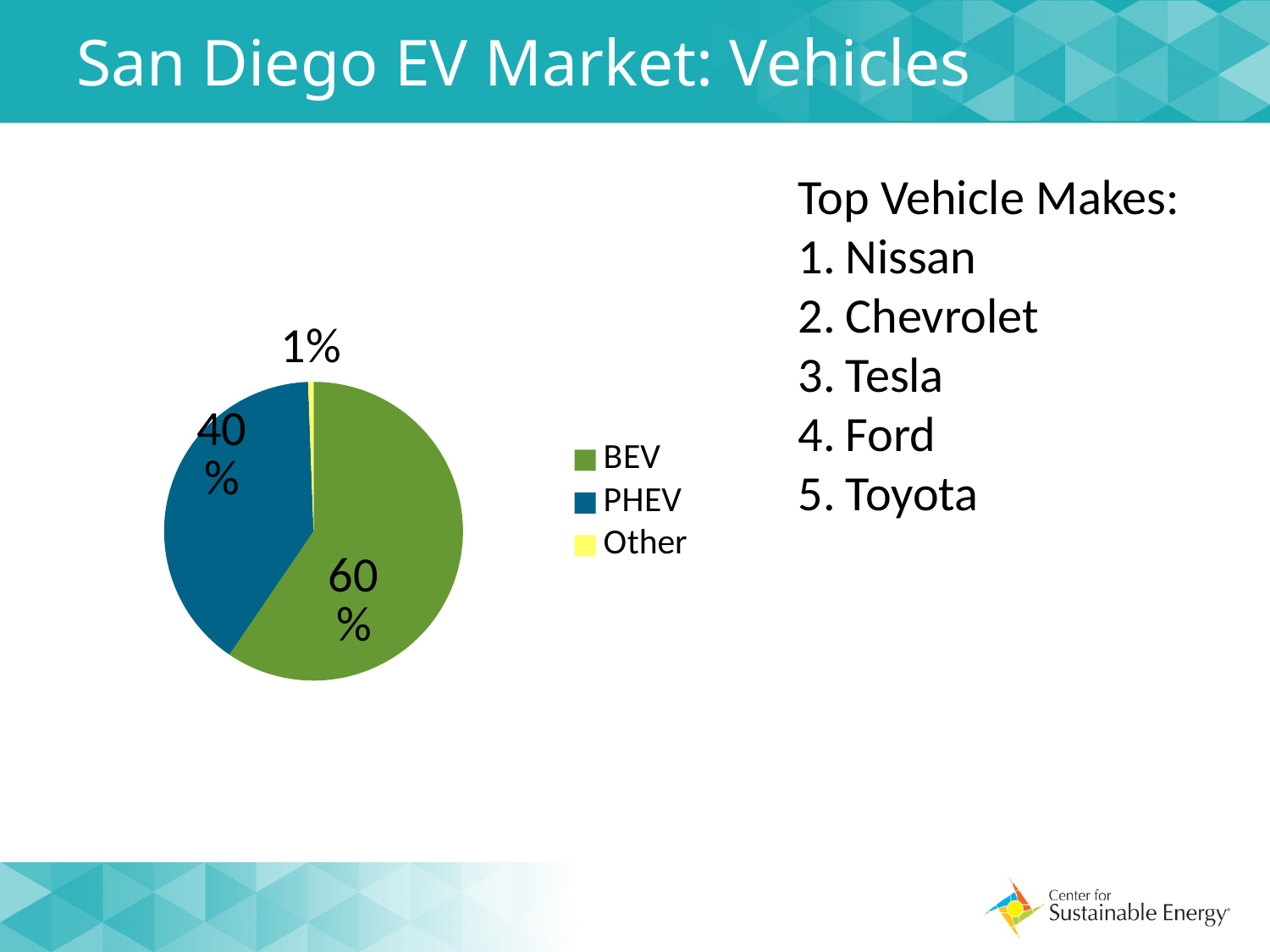
What colour is the BEV slice in the pie chart? green Which slice is larger, PHEV or Other? PHEV Which legend entry is shown in yellow? Other What share of the pie does Other represent? 1% What share of the pie does BEV represent? 60% What share of the pie does PHEV represent? 40% Which category has the largest slice of the pie? BEV Which category has the smallest slice of the pie? Other What is the difference in percentage points between the BEV and PHEV slices? 20 How many entries does the legend list? 3 What kind of chart is shown on the slide? pie chart How many categories does the pie chart show? 3